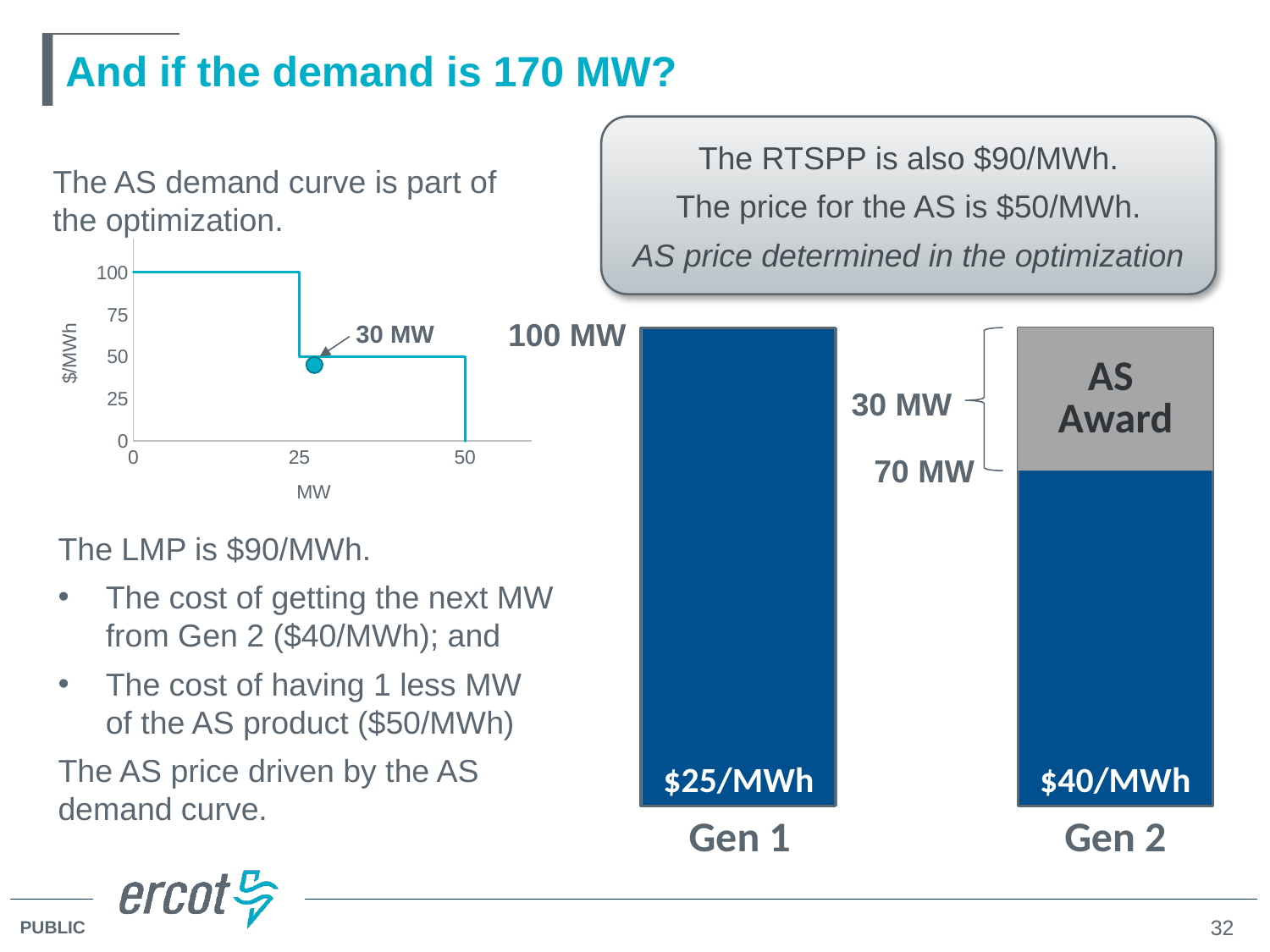
In the bar chart on the right, what is the total height of the Gen 2 stacked bar (70 MW plus the 30 MW AS Award)? 100 MW How many generator bars are shown in the bar chart on the right? 2 In the AS demand curve chart on the left, do the values rise or fall as MW increases along the x axis? fall In the bar chart on the right, what price is printed on the Gen 1 bar? $25/MWh In the AS demand curve chart on the left, what is the $/MWh value of the curve between 0 and 25 MW? 100 What kind of chart is the AS demand curve chart on the left? line chart In the bar chart on the right, what is the MW value labelled for Gen 1? 100 MW In the bar chart on the right, what price is printed on the Gen 2 bar? $40/MWh In the bar chart on the right, how many MW is the AS Award segment on Gen 2? 30 MW In the AS demand curve chart on the left, what is the $/MWh value of the curve between 25 and 50 MW? 50 What kind of chart is the chart on the right showing Gen 1 and Gen 2? bar chart In the bar chart on the right, how many MW of Gen 2's bar is the energy portion below the AS Award? 70 MW